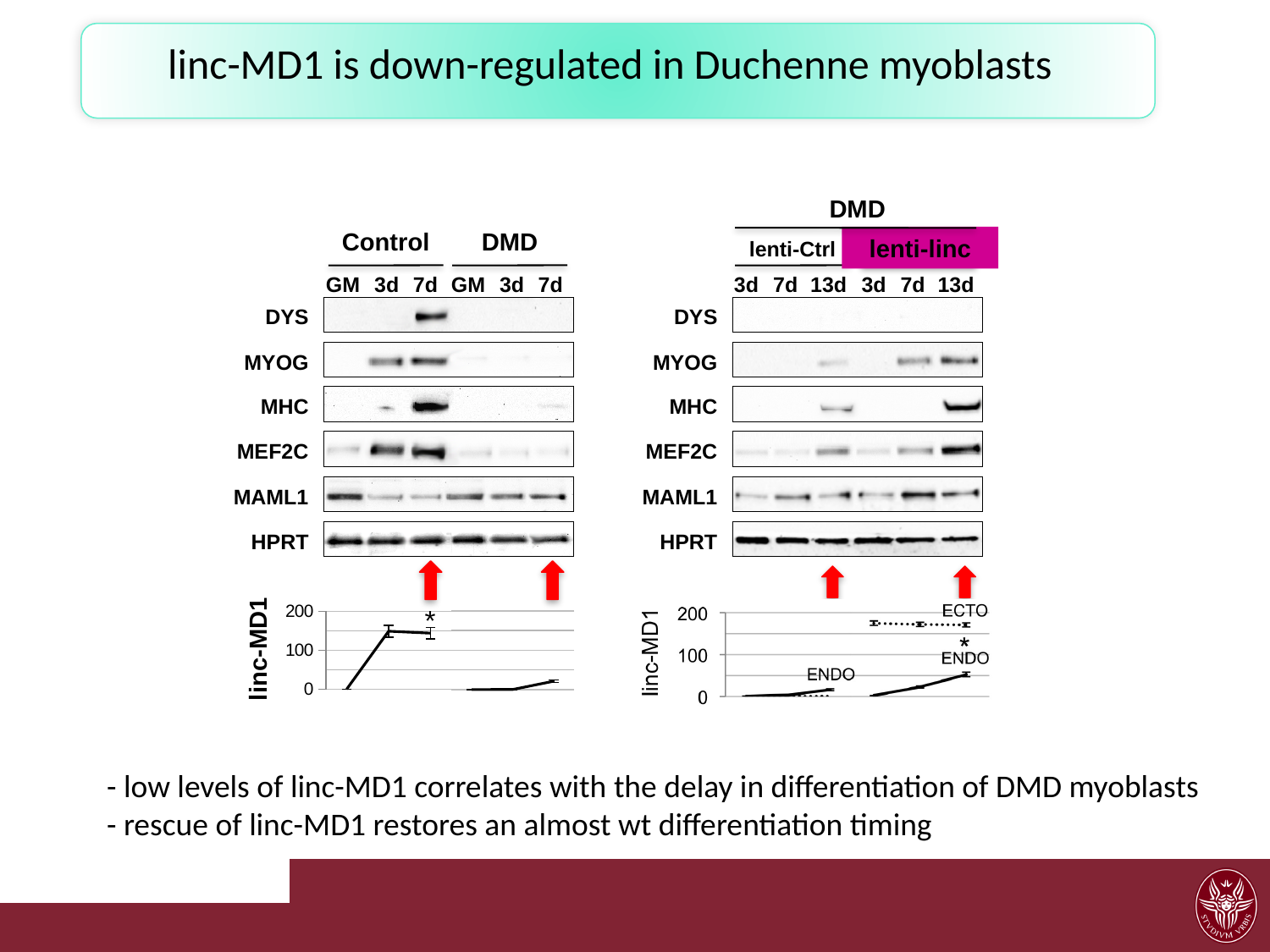
In the left linc-MD1 chart, is the Control value at 7d greater or less than 100? greater What kind of chart is the left linc-MD1 chart (below the Control/DMD blots)? line chart In the left linc-MD1 chart, does the Control line rise or fall from GM to 3d? rise In the left linc-MD1 chart, is the DMD value at 7d greater or less than 100? less What is the highest tick value shown on the y axis of the left linc-MD1 chart? 200 In the right linc-MD1 chart (below the lenti-Ctrl/lenti-linc blots), is the ECTO value at 13d greater or less than 100? greater In the right linc-MD1 chart, does the lenti-linc ENDO line rise or fall from 3d to 13d? rise In the left linc-MD1 chart, which is larger at 7d: the Control value or the DMD value? Control In the right linc-MD1 chart, which is larger in lenti-linc at 13d: ECTO or ENDO? ECTO What are the two line labels shown in the right linc-MD1 chart? ENDO and ECTO